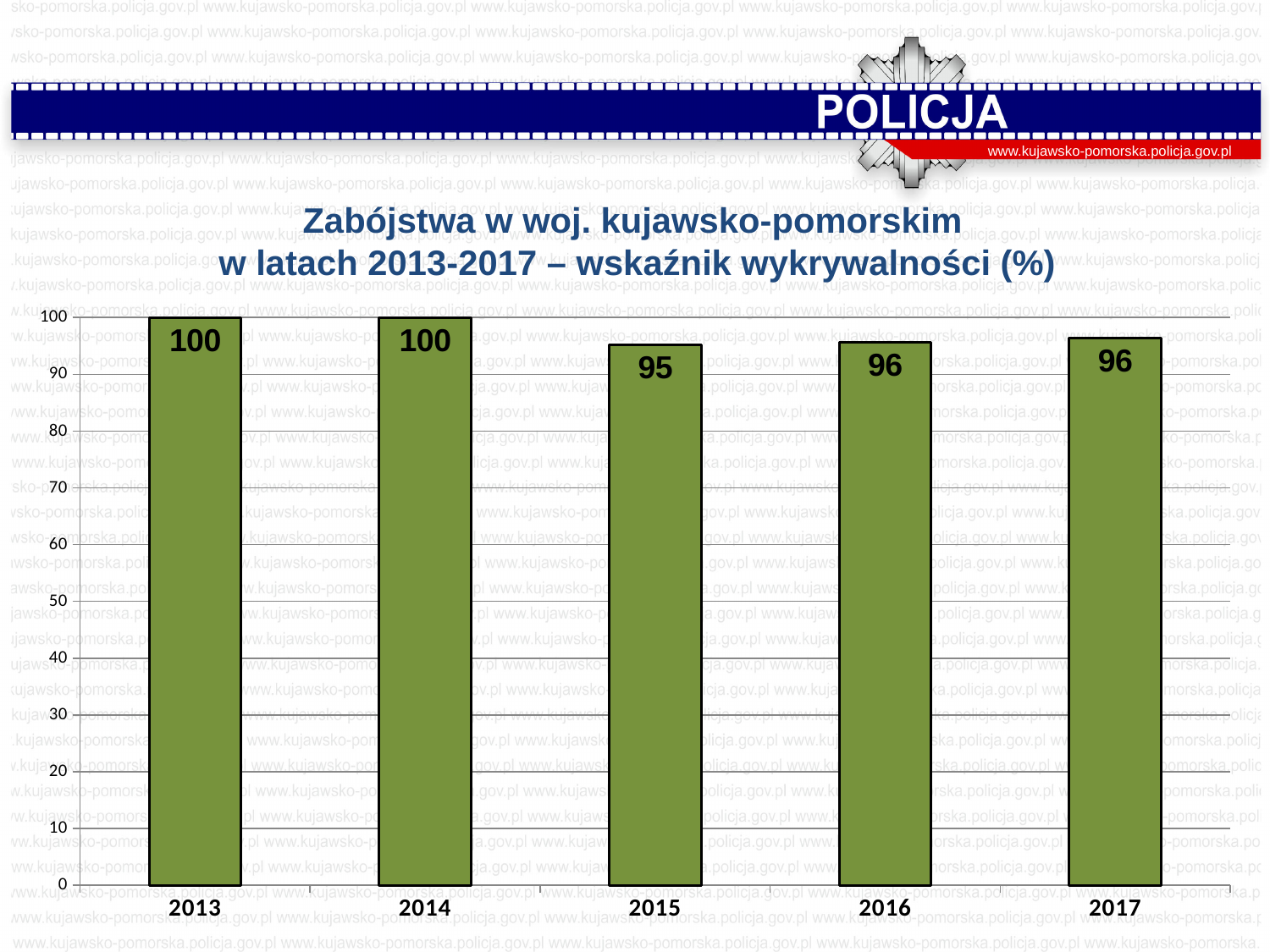
Is the value for 2016 greater or less than 90? greater Which year has the lowest value on the chart? 2015 Which is larger, the value for 2013 or the value for 2016? 2013 What kind of chart is shown on the slide? bar chart What is the value shown for 2017? 96 What colour are the bars in the chart? green What is the maximum value shown on the y axis of the chart? 100 How many years are shown on the x axis of the chart? 5 What is the detection rate value shown for 2015? 95 Do the values rise or fall from 2014 to 2015? fall What is the value shown for 2013? 100 What is the difference between the values for 2014 and 2015? 5